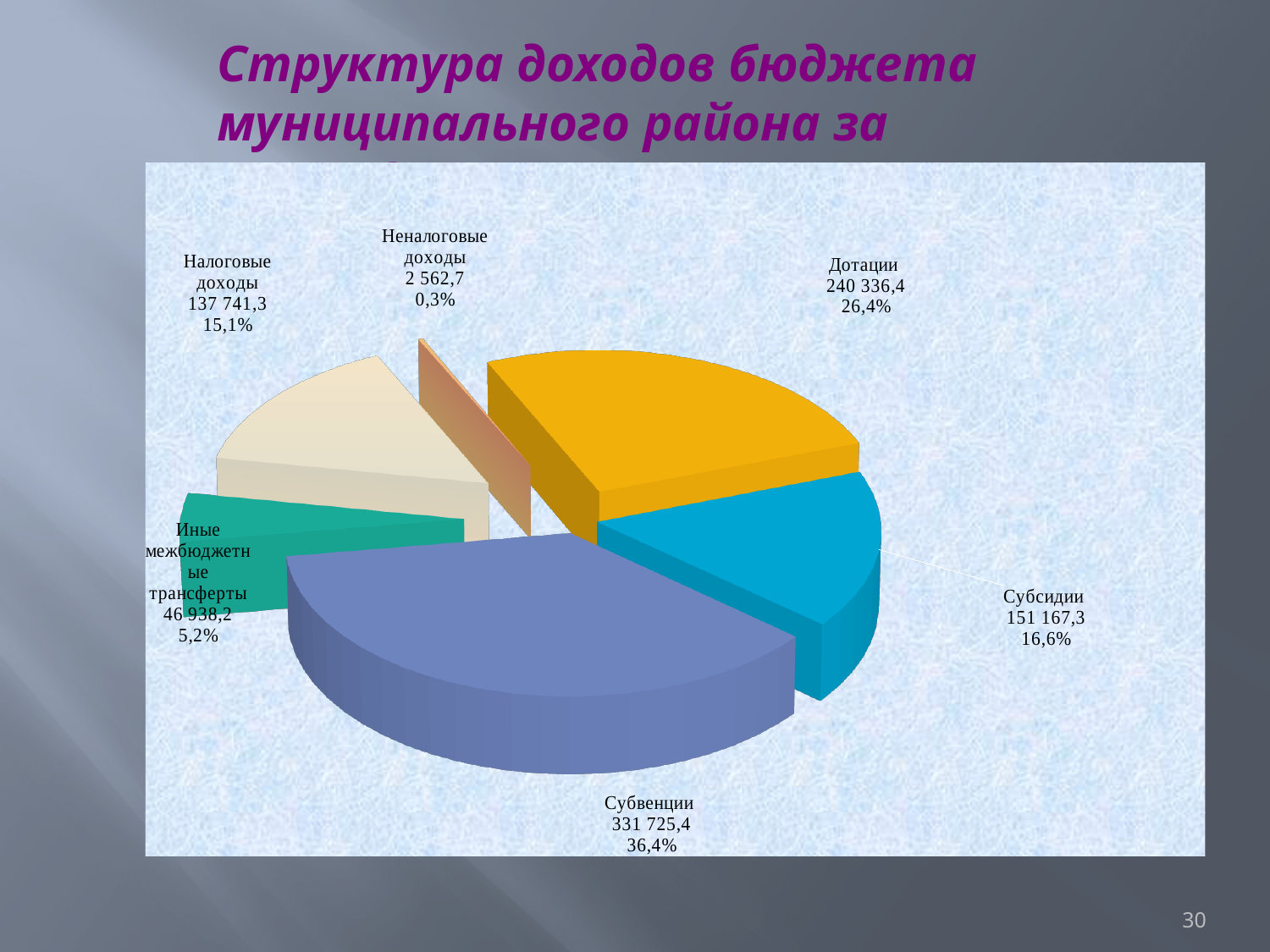
What share of the pie does Неналоговые доходы represent? 0,3% What is the difference between the values for Субвенции and Дотации? 91 389,0 Which is larger, Субсидии or Налоговые доходы? Субсидии How many slices does the pie chart have? 6 What colour is the Субвенции slice? blue-purple What share of the pie does Дотации represent? 26,4% Which category has the largest slice of the pie? Субвенции What kind of chart is shown on the slide? pie chart What is the value shown for Иные межбюджетные трансферты? 46 938,2 Which category has the smallest slice of the pie? Неналоговые доходы What is the value shown for Налоговые доходы? 137 741,3 What is the value shown for Субвенции? 331 725,4